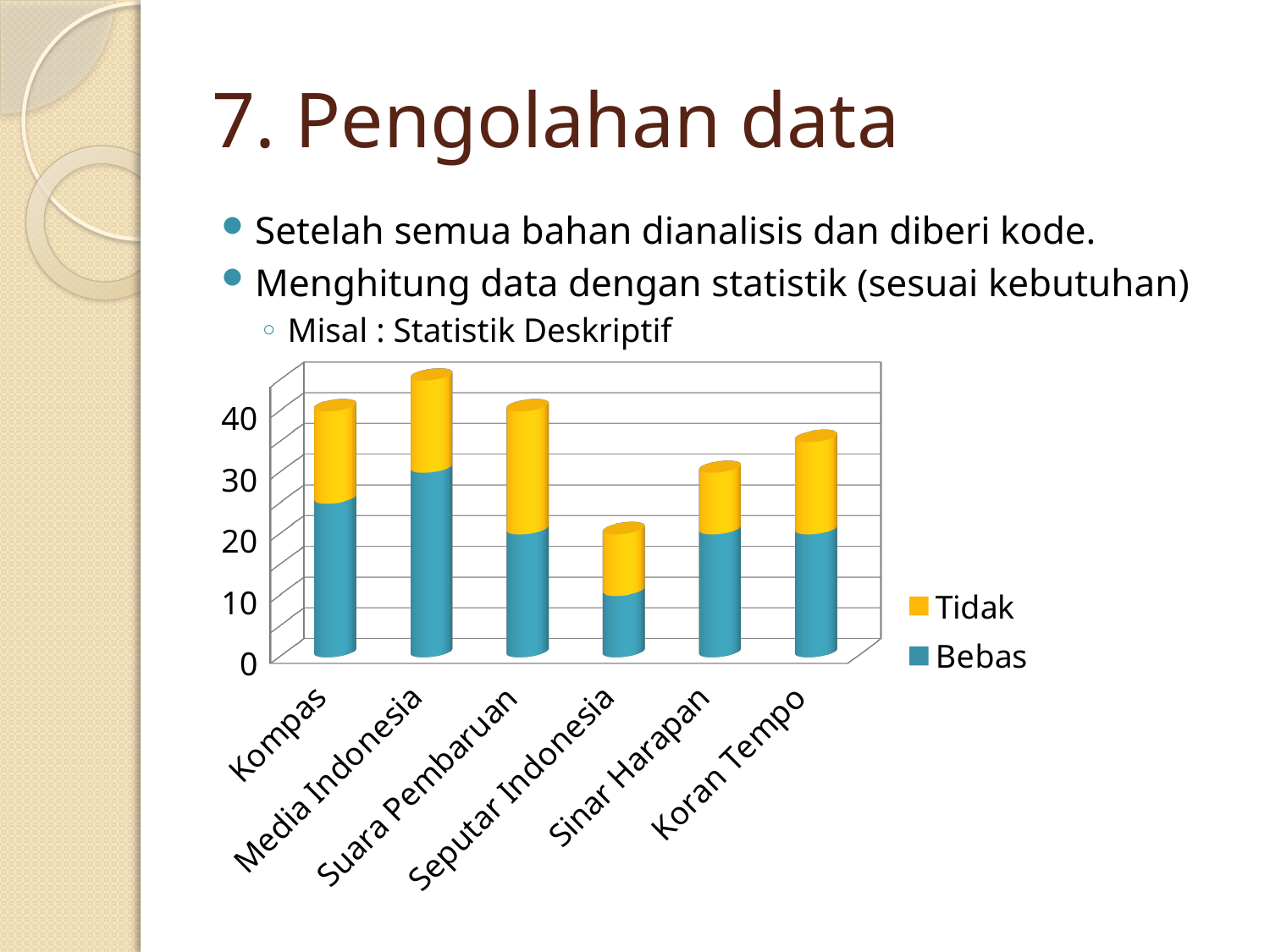
Which has a taller stacked bar, Media Indonesia or Seputar Indonesia? Media Indonesia Which newspaper has the shortest stacked bar in the chart? Seputar Indonesia Is the Bebas value for Seputar Indonesia greater or less than 20? less Is the total stacked value for Media Indonesia greater or less than 40? greater How many categories (newspapers) are shown on the x axis of the chart? 6 Which series is shown in yellow in the chart? Tidak What kind of chart is shown on the slide? bar chart What are the two series names listed in the chart's legend? Tidak and Bebas How many series does the chart's legend list? 2 Which newspaper has the tallest stacked bar in the chart? Media Indonesia Is the total stacked value for Seputar Indonesia greater or less than 30? less Which has a taller stacked bar, Kompas or Sinar Harapan? Kompas